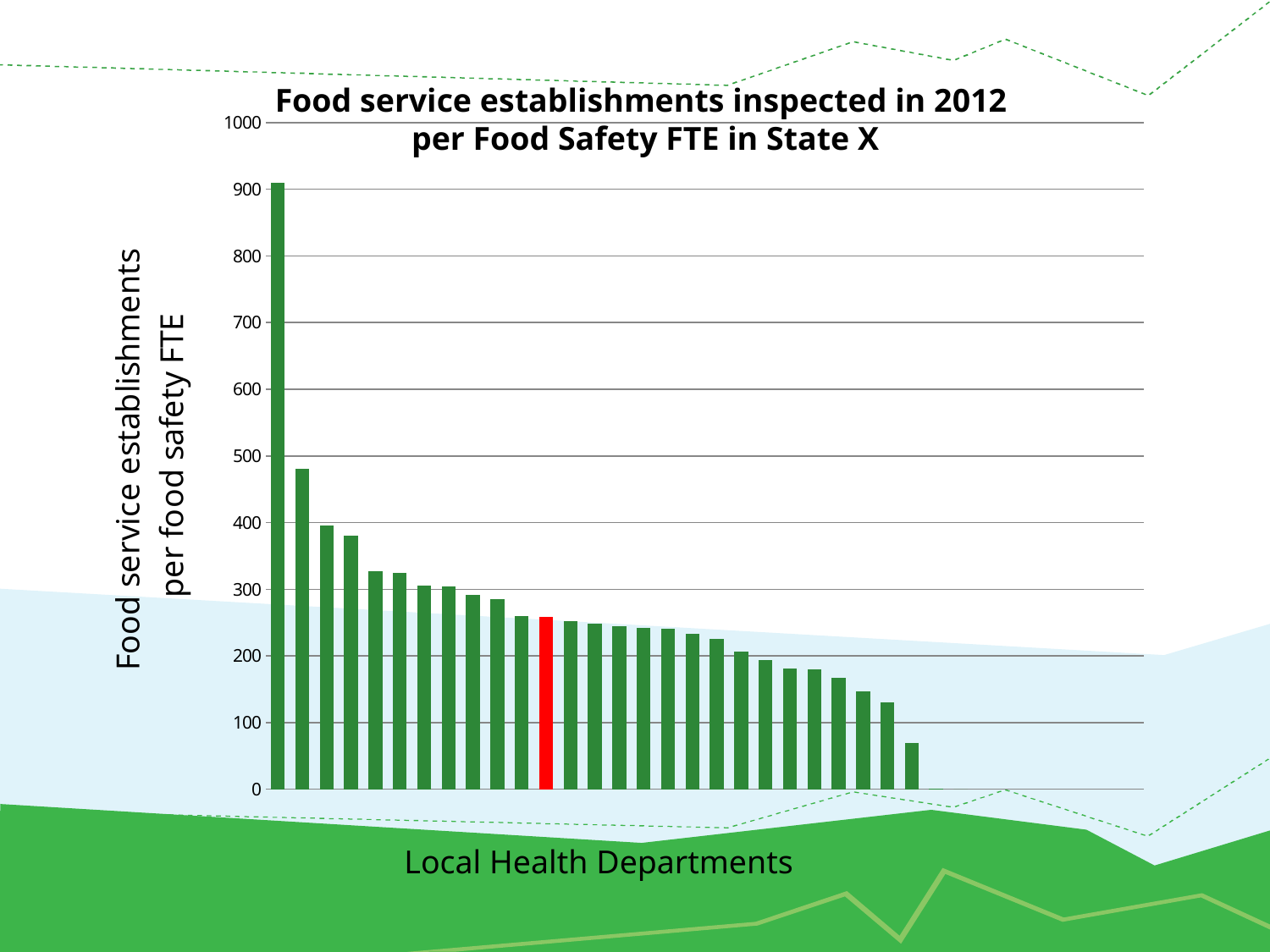
What is the label on the horizontal axis of the chart? Local Health Departments Is the value of the second-tallest bar greater or less than 500? less Is the value of the red bar greater or less than 200? greater Do the bar values rise or fall from left to right across the chart? fall Is the value of the red bar greater or less than 300? less What kind of chart is shown on the slide? bar chart Which bar has the highest value in the chart? the leftmost bar What is the title of the chart? Food service establishments inspected in 2012 per Food Safety FTE in State X Is the leftmost bar taller or shorter than the red bar? taller